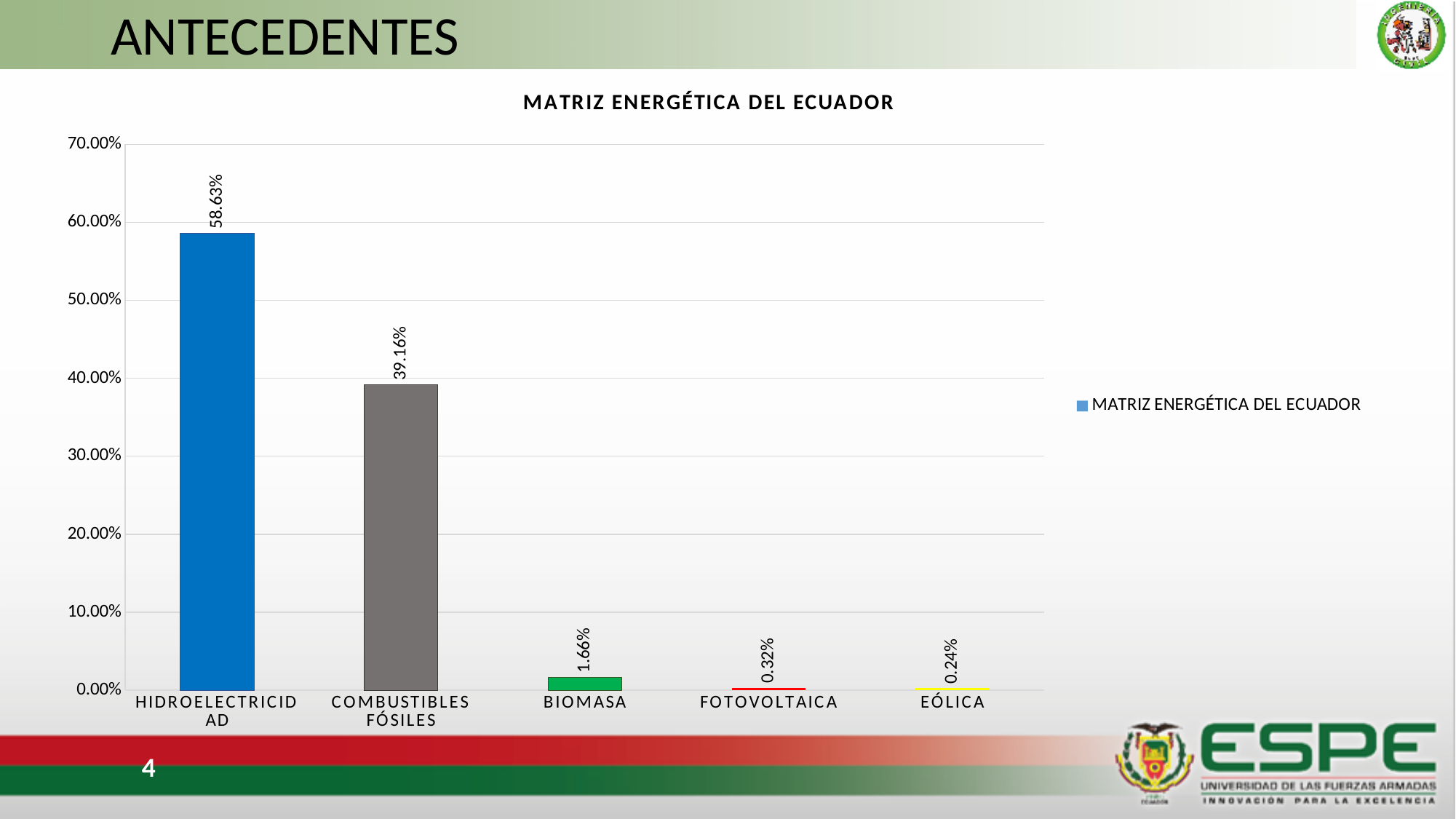
What is the value for Eólica? 0.24% Which category has the lowest value? Eólica What is the value for Combustibles Fósiles? 39.16% How many categories are shown on the x axis? 5 What kind of chart is shown on the slide? Bar chart What is the value for Fotovoltaica? 0.32% What is the value for Biomasa? 1.66% What is the value for Hidroelectricidad? 58.63% Which is larger, the value for Biomasa or the value for Fotovoltaica? Biomasa What is the title of the chart? MATRIZ ENERGÉTICA DEL ECUADOR Which category has the highest value? Hidroelectricidad What is the difference between the values for Hidroelectricidad and Combustibles Fósiles? 19.47%